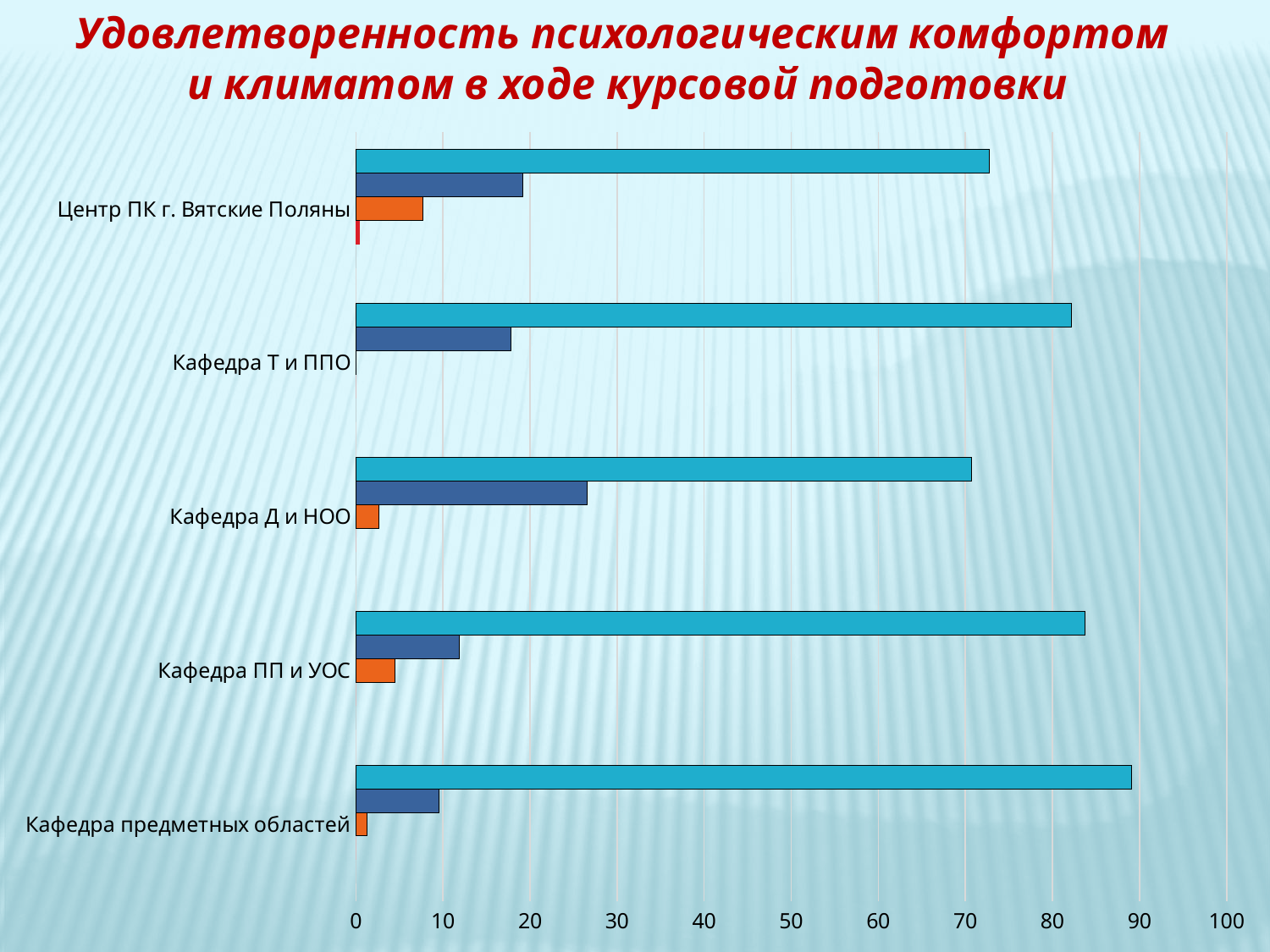
Which category has the shortest dark blue bar? Кафедра предметных областей What is the maximum value shown on the horizontal axis of the chart? 100 Is the light blue bar for Центр ПК г. Вятские Поляны greater or less than 80? less Which category has the longest dark blue bar? Кафедра Д и НОО Which has the longer dark blue bar: Центр ПК г. Вятские Поляны or Кафедра ПП и УОС? Центр ПК г. Вятские Поляны Is the dark blue bar for Кафедра Д и НОО greater or less than 20? greater Which has the longer light blue bar: Кафедра Т и ППО or Центр ПК г. Вятские Поляны? Кафедра Т и ППО How many categories (departments) are listed on the vertical axis of the chart? 5 What kind of chart is shown on the slide? bar chart Is the light blue bar for Кафедра предметных областей greater or less than 80? greater Which category has the longest light blue bar? Кафедра предметных областей